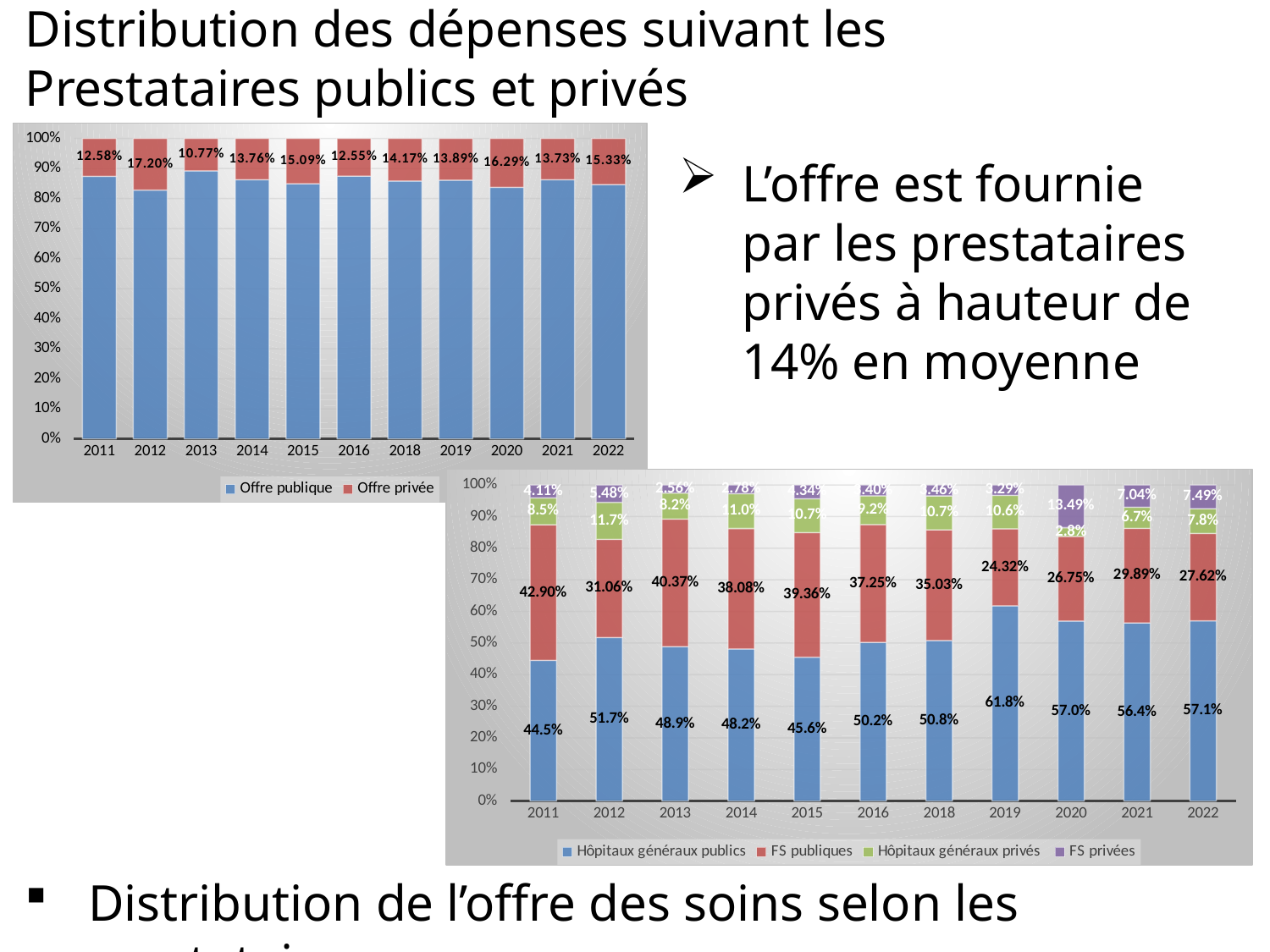
In the top-left chart, how many series does the legend list? 2 In the top-left chart, what is the value of Offre privée for 2012? 17.20% In the bottom-right chart, is the value of FS publiques larger in 2011 or in 2019? 2011 In the top-left chart, what is the value of Offre privée for 2013? 10.77% In the bottom-right chart, what is the value of FS publiques for 2011? 42.90% In the bottom-right chart, which year has the highest Hôpitaux généraux publics value? 2019 In the top-left chart, which year has the lowest Offre privée value? 2013 In the bottom-right chart, how many series does the legend list? 4 In the top-left chart, which year has the highest Offre privée value? 2012 In the top-left chart, how many years are shown on the x axis? 11 In the bottom-right chart, what is the value of Hôpitaux généraux publics for 2019? 61.8% What kind of chart is the bottom-right chart? Stacked bar chart